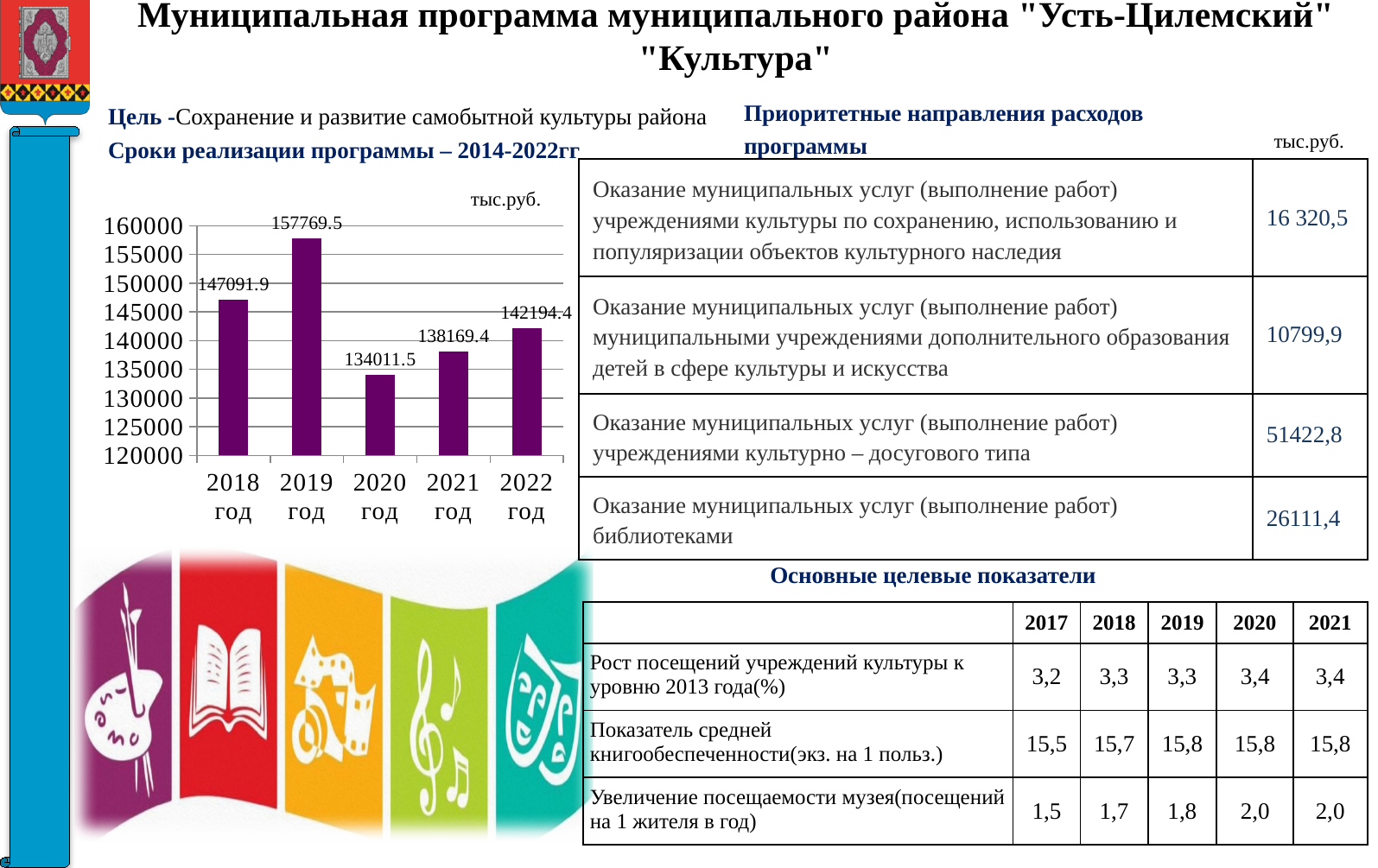
What is the value for 2020 год in the bar chart? 134011.5 What unit is indicated above the bar chart? тыс.руб. What is the value for 2022 год in the bar chart? 142194.4 What is the difference between the values for 2019 год and 2020 год in the bar chart? 23758 Is the value for 2021 год in the bar chart greater or less than 140000? less What type of chart is shown on the slide? bar chart Which year has the lowest value in the bar chart? 2020 год Which year has the highest value in the bar chart? 2019 год Which is larger in the bar chart: the value for 2018 год or the value for 2022 год? 2018 год Do the values in the bar chart rise or fall from 2020 год to 2022 год? rise How many bars are shown in the bar chart? 5 What is the value for 2019 год in the bar chart? 157769.5